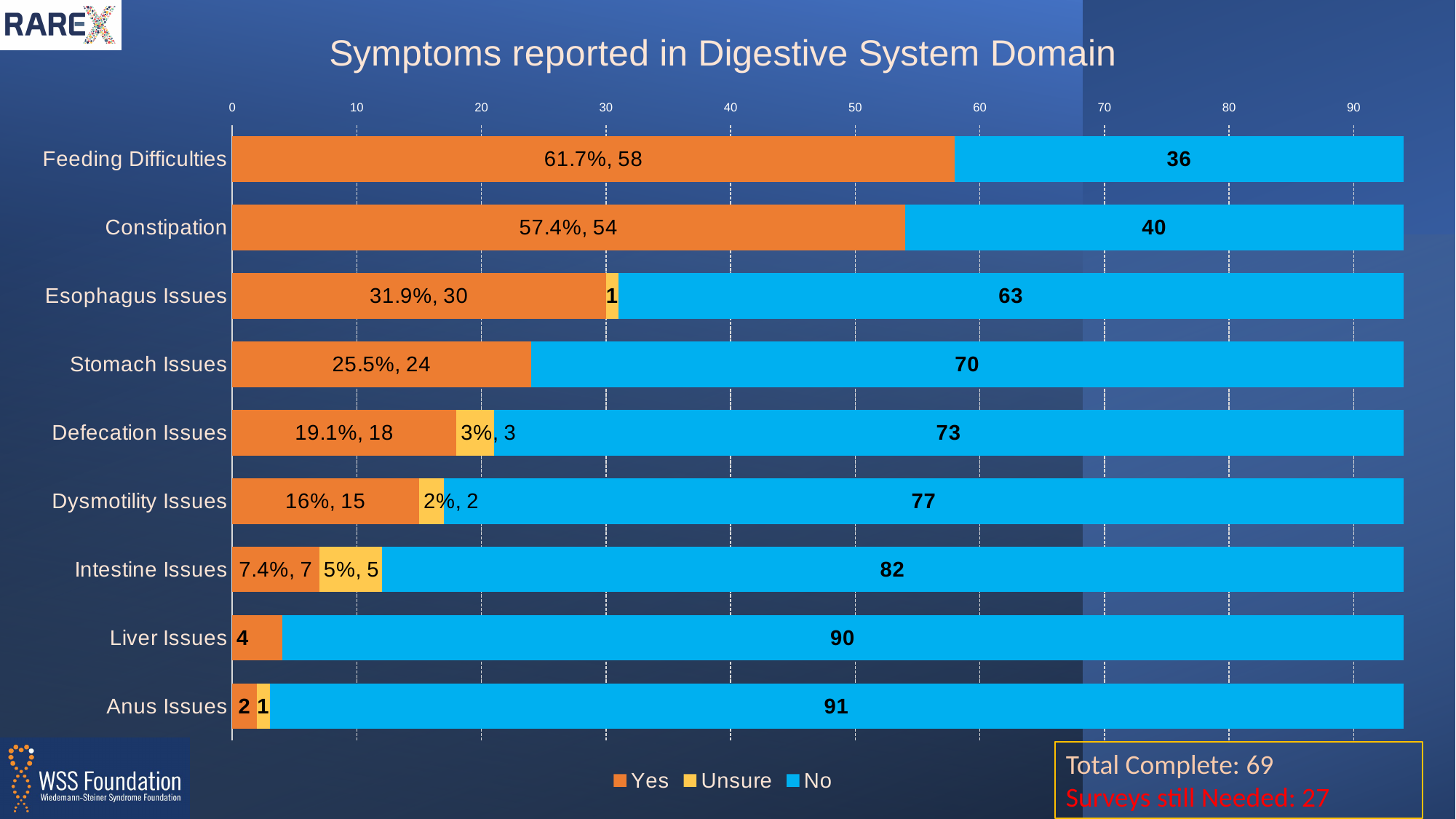
How many respondents answered Yes for Constipation? 54 How many symptom categories are shown in the chart? 9 What kind of chart is shown on the slide? Stacked bar chart What is the difference between the Yes counts for Feeding Difficulties and Constipation? 4 How many respondents were Unsure about Intestine Issues? 5 What is the No count for Stomach Issues? 70 Which symptom has the lowest No count? Feeding Difficulties How many series does the legend list? 3 Which symptom has the highest Yes count? Feeding Difficulties What is the total of the Yes, Unsure and No counts for Esophagus Issues? 94 What percentage of respondents answered Yes for Stomach Issues? 25.5% Which has a larger No count, Defecation Issues or Dysmotility Issues? Dysmotility Issues